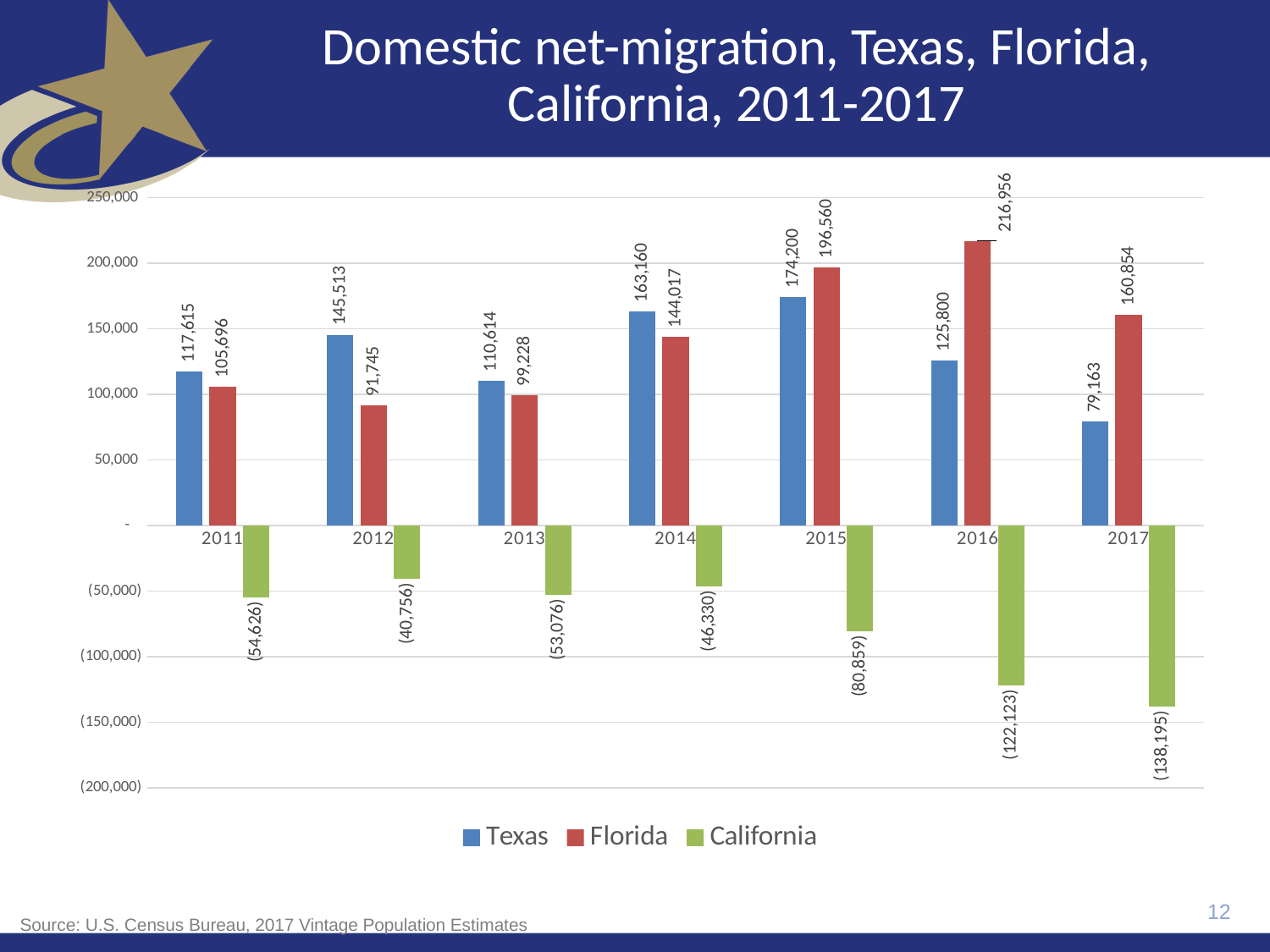
In which year is the Texas value lowest? 2017 What is the value for Texas in 2014? 163,160 What is the difference between the Texas and Florida values in 2011? 11,919 In 2015, which is larger, the Texas value or the Florida value? Florida How many series does the legend list? 3 What is the value for Florida in 2012? 91,745 In which year is the Florida value highest? 2016 How many years are shown on the x axis? 7 What is the value for California in 2016? (122,123) What kind of chart is shown on the slide? bar chart Does the Florida value rise or fall from 2014 to 2016? rise Is the value for Texas in 2016 greater or less than 150,000? less